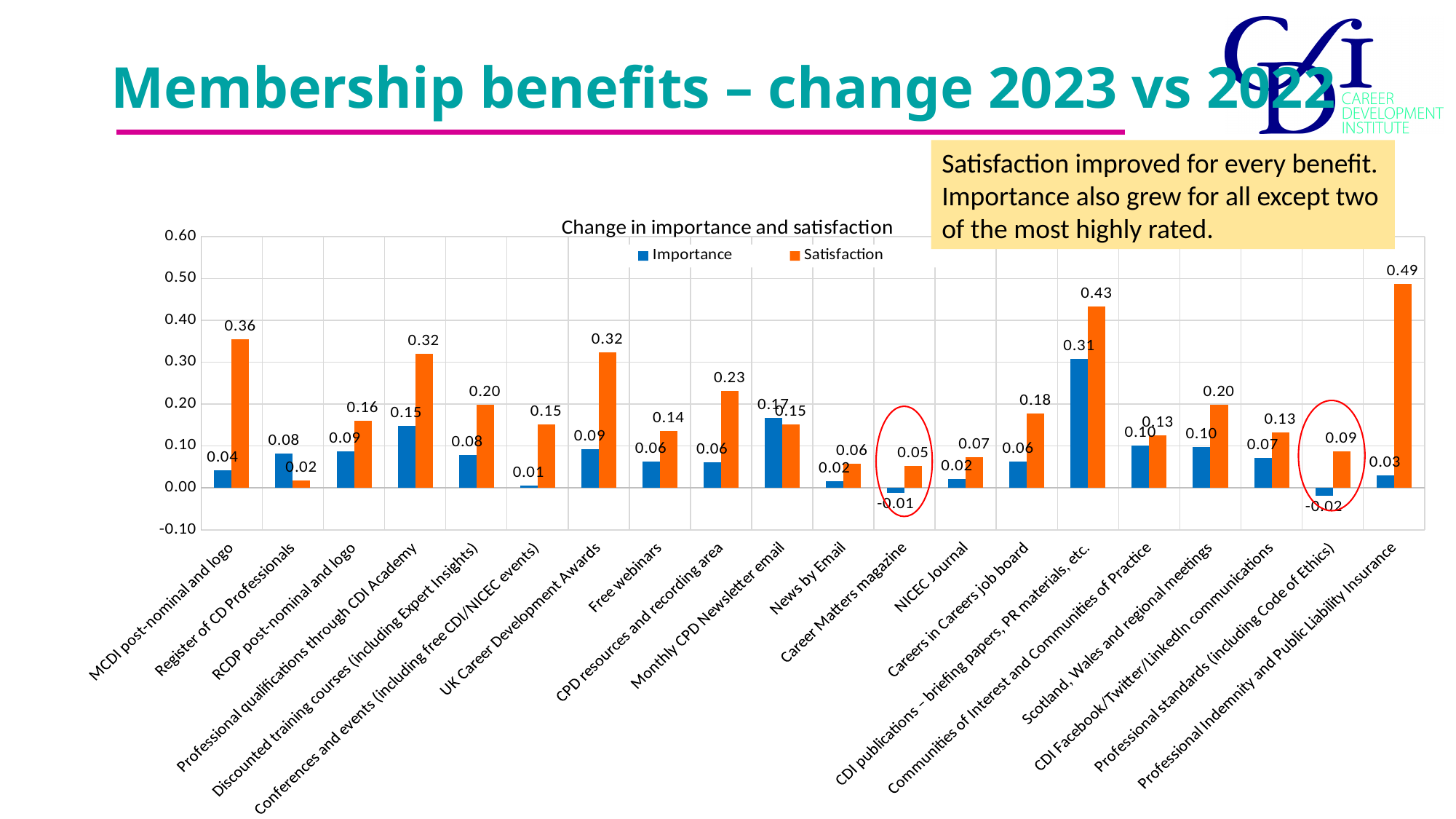
For Register of CD Professionals, which is larger: Importance or Satisfaction? Importance What is the Satisfaction value for UK Career Development Awards? 0.32 What is the difference between the Satisfaction and Importance values for Professional Indemnity and Public Liability Insurance? 0.46 Which category has the highest Satisfaction value? Professional Indemnity and Public Liability Insurance Which category has the lowest Importance value? Professional standards (including Code of Ethics) What is the Satisfaction value for Professional Indemnity and Public Liability Insurance? 0.49 How many series does the chart legend list? 2 What is the Importance value for CDI publications – briefing papers, PR materials, etc.? 0.31 What type of chart is shown on the slide? Bar chart How many categories are shown on the x axis of the chart? 20 Which category has the highest Importance value? CDI publications – briefing papers, PR materials, etc. What is the Importance value for Professional standards (including Code of Ethics)? -0.02